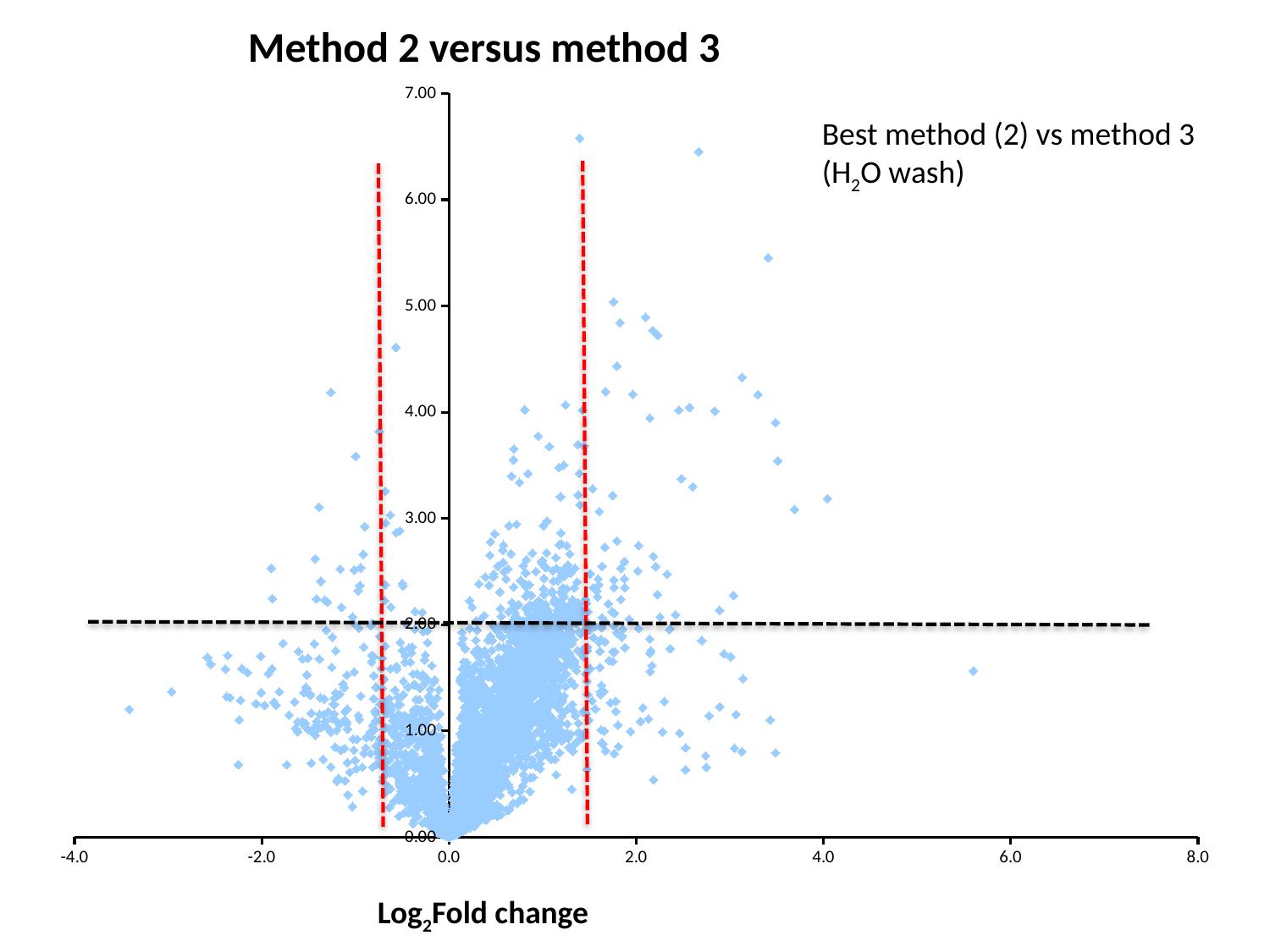
How many vertical red dashed lines are drawn on the chart? 2 What is the label of the x axis? Log2Fold change At what y-axis value is the horizontal black dashed line drawn? 2.00 Is the y value of the highest point on the chart greater or less than 6.00? greater What is the highest tick value shown on the x axis? 8.0 Is the x value of the rightmost point on the chart greater or less than 5.0? greater What is the title of the chart? Method 2 versus method 3 What is the lowest tick value shown on the x axis? -4.0 What kind of chart is shown on the slide? scatter plot What is the highest tick value shown on the y axis? 7.00 Is the x value of the leftmost point on the chart greater or less than -3.0? less